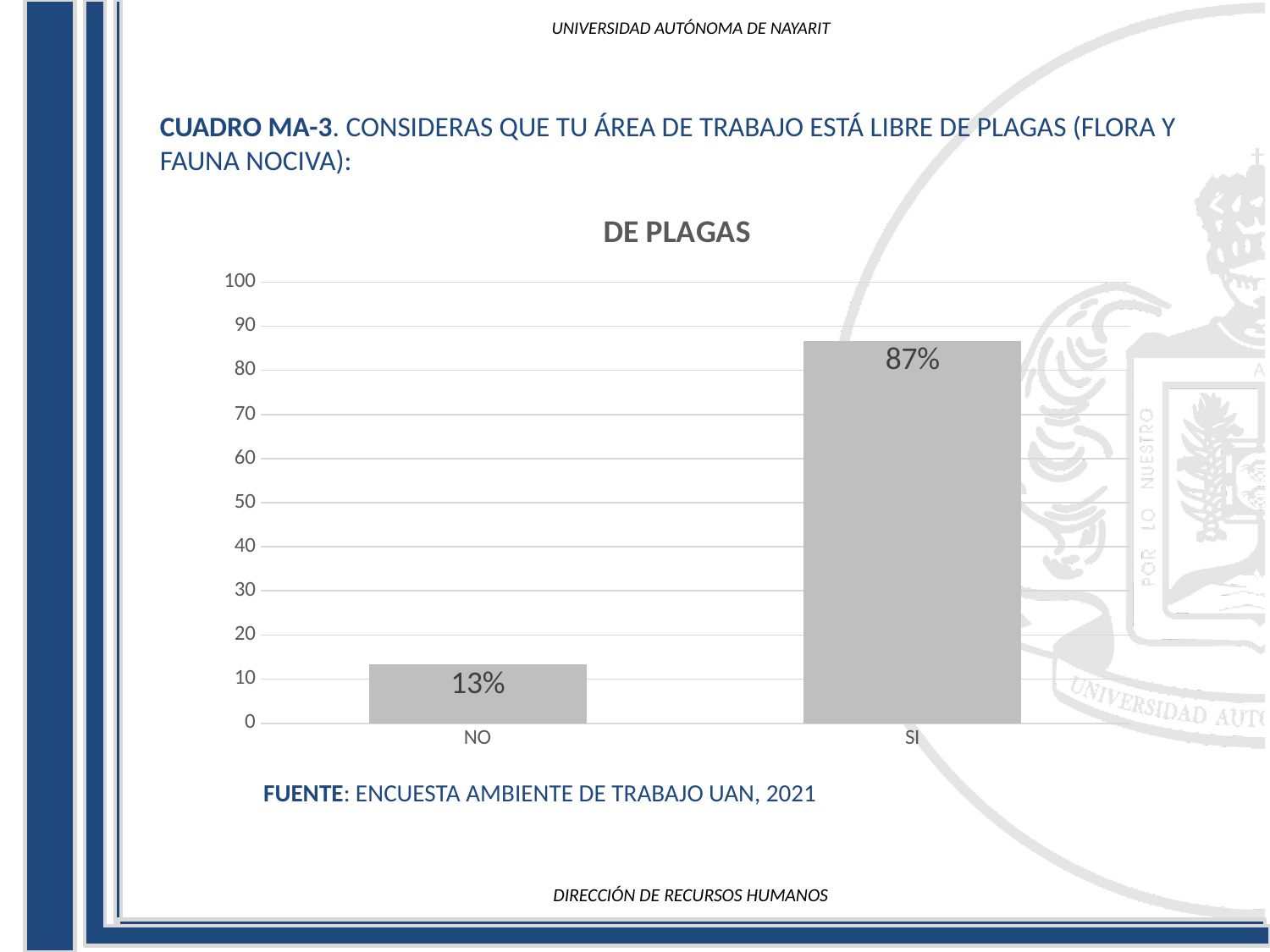
What is the value for NO? 13% Which is larger, the value for NO or the value for SI? SI What kind of chart is shown on the slide? bar chart What is the title of the chart? DE PLAGAS What is the difference between the values for SI and NO? 74% Which category has the highest value? SI Is the value for NO greater or less than 20? less Which category has the lowest value? NO What is the highest value shown on the vertical axis? 100 How many categories are shown on the x axis? 2 Is the value for SI greater or less than 80? greater What is the value for SI? 87%